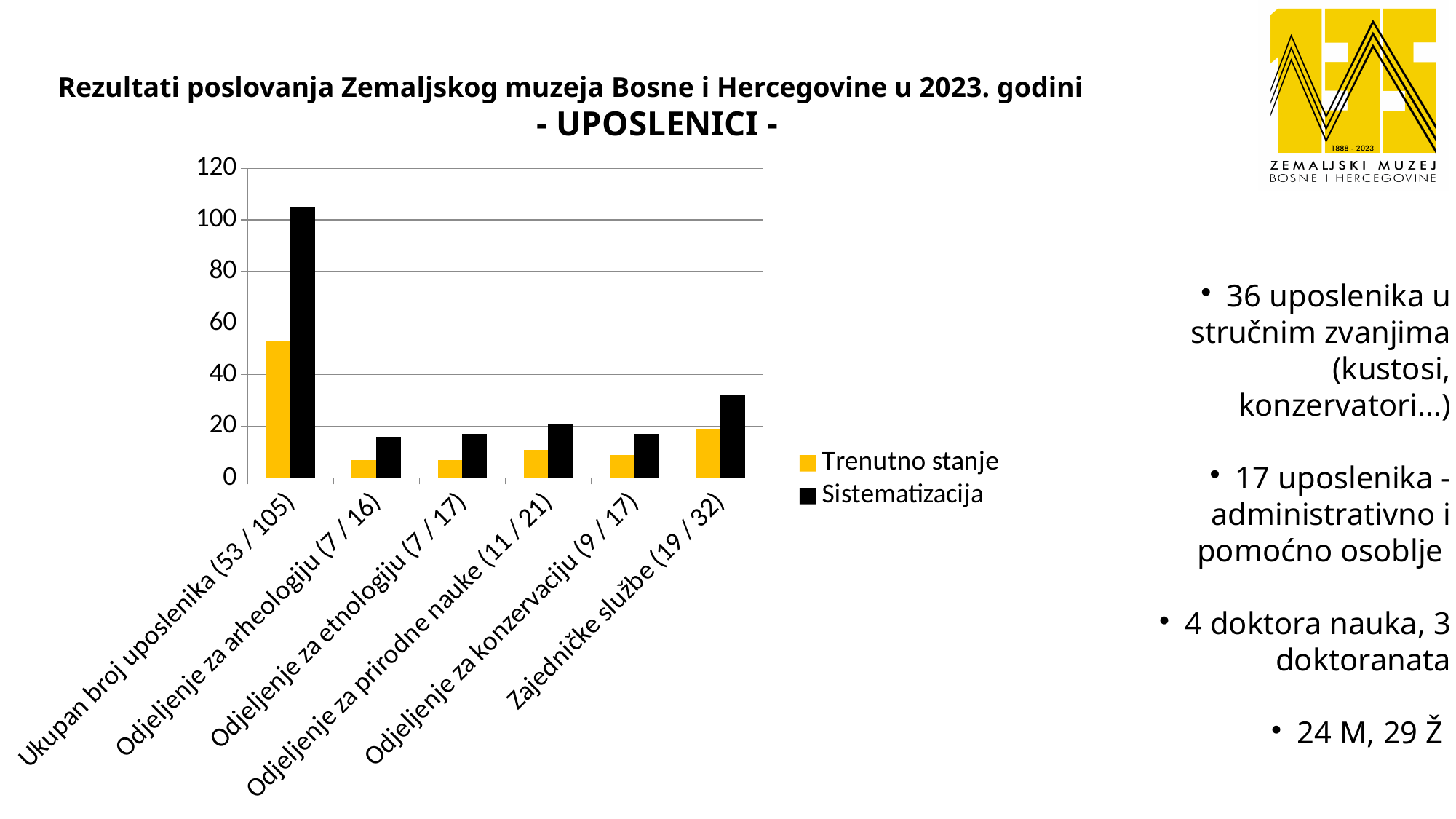
What is the Trenutno stanje value for Odjeljenje za prirodne nauke? 11 What is the difference between the Sistematizacija and Trenutno stanje values for Zajedničke službe? 13 Is the Sistematizacija value for Ukupan broj uposlenika greater or less than 100? greater Which is larger for Odjeljenje za konzervaciju: the Trenutno stanje value or the Sistematizacija value? Sistematizacija Which category has the highest Trenutno stanje value? Ukupan broj uposlenika What is the Sistematizacija value for Zajedničke službe? 32 How many series does the chart legend list? 2 What colour are the Trenutno stanje bars in the chart? yellow What is the Sistematizacija value for Ukupan broj uposlenika? 105 What kind of chart is shown on the slide? bar chart How many categories are shown on the x axis of the chart? 6 Which category has the lowest Sistematizacija value? Odjeljenje za arheologiju